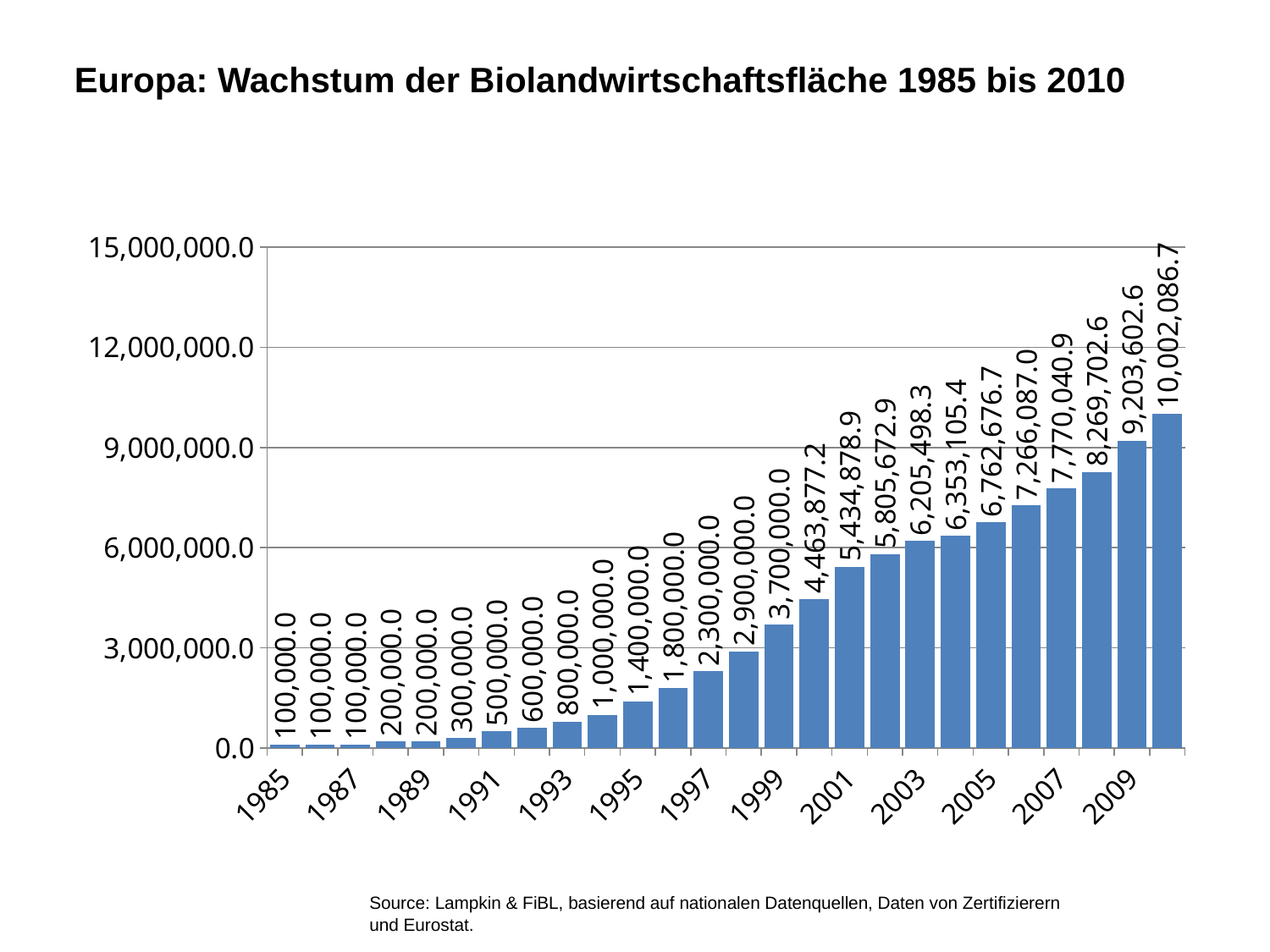
Which is larger, the value for 2001 or the value for 2003? 2003 What kind of chart is shown on the slide? bar chart What is the difference between the values for 2009 and 2007? 1,433,561.7 What is the value for 2010? 10,002,086.7 What is the value for 1991? 500,000.0 How many bars are plotted in the chart? 26 What is the value for 1999? 3,700,000.0 Which year has the highest value? 2010 Is the value for 2007 greater or less than 6,000,000.0? greater What is the title of the chart? Europa: Wachstum der Biolandwirtschaftsfläche 1985 bis 2010 What is the value for 2005? 6,762,676.7 Do the values rise or fall from 1985 to 2010? rise